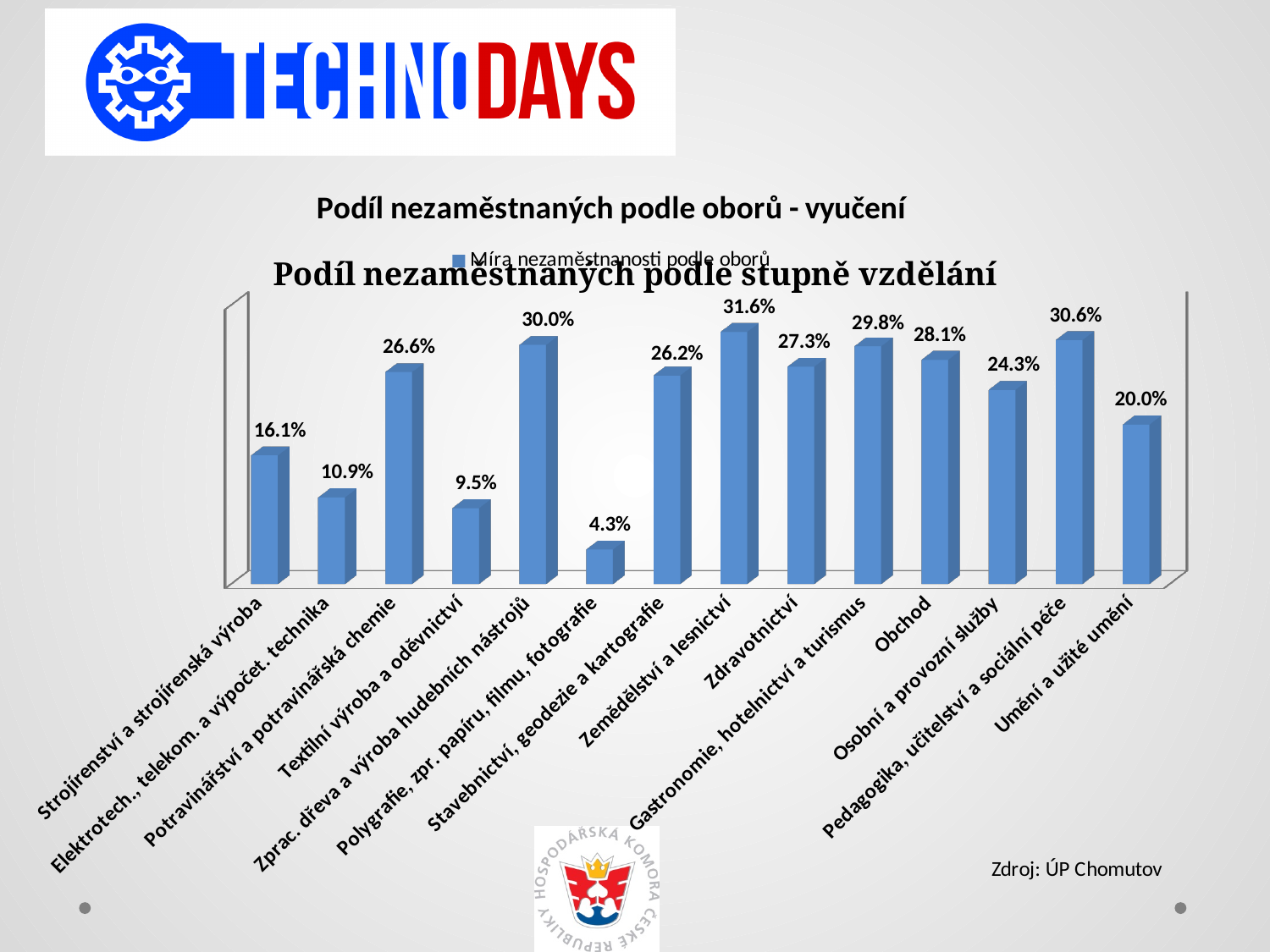
What is the difference between the values for Obchod and Osobní a provozní služby? 3.8% What is the value for Zdravotnictví? 27.3% How many categories are shown on the chart? 14 Which is larger, the value for Potravinářství a potravinářská chemie or the value for Stavebnictví, geodezie a kartografie? Potravinářství a potravinářská chemie How many series does the legend list? 1 What is the value for Umění a užité umění? 20.0% Which category has the highest value? Zemědělství a lesnictví What is the legend entry of the chart? Míra nezaměstnanosti podle oborů What kind of chart is shown? Bar chart What is the value for Strojírenství a strojírenská výroba? 16.1% What is the value for Textilní výroba a oděvnictví? 9.5% Which category has the lowest value? Polygrafie, zpr. papíru, filmu, fotografie